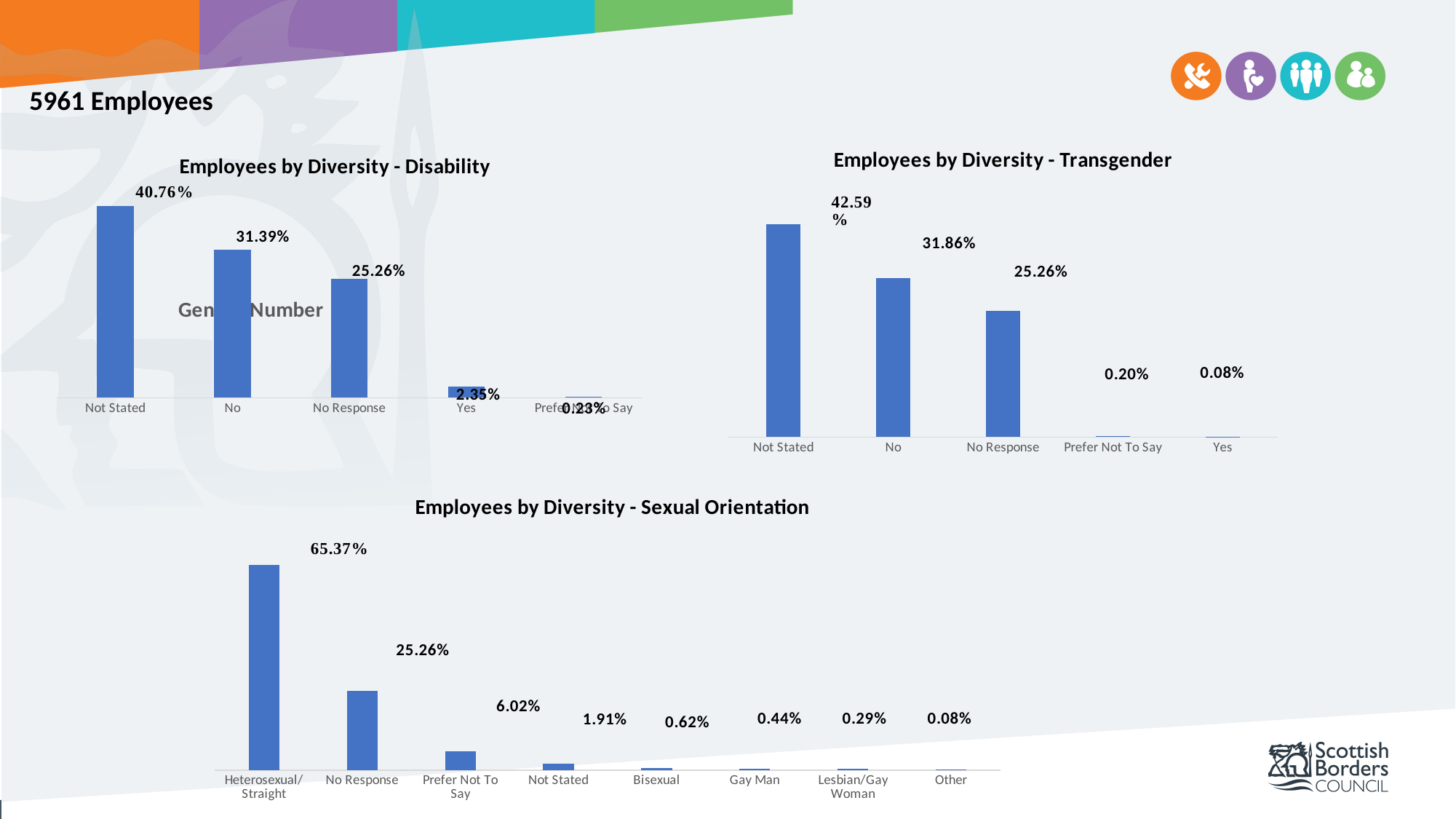
In the 'Employees by Diversity - Sexual Orientation' chart, what is the value for Heterosexual/Straight? 65.37% In the 'Employees by Diversity - Transgender' chart, which is larger, Prefer Not To Say or Yes? Prefer Not To Say In the 'Employees by Diversity - Disability' chart, what is the value for Not Stated? 40.76% In the 'Employees by Diversity - Transgender' chart, which category has the lowest value? Yes In the 'Employees by Diversity - Disability' chart, what is the difference between the values for Not Stated and No? 9.37% In the 'Employees by Diversity - Disability' chart, which category has the highest value? Not Stated In the 'Employees by Diversity - Transgender' chart, how many categories are shown? 5 What kind of chart is 'Employees by Diversity - Sexual Orientation'? Bar chart In the 'Employees by Diversity - Transgender' chart, what is the value for No? 31.86% In the 'Employees by Diversity - Sexual Orientation' chart, how many categories are shown? 8 In the 'Employees by Diversity - Disability' chart, what is the value for Yes? 2.35% In the 'Employees by Diversity - Sexual Orientation' chart, what is the difference between the values for No Response and Prefer Not To Say? 19.24%